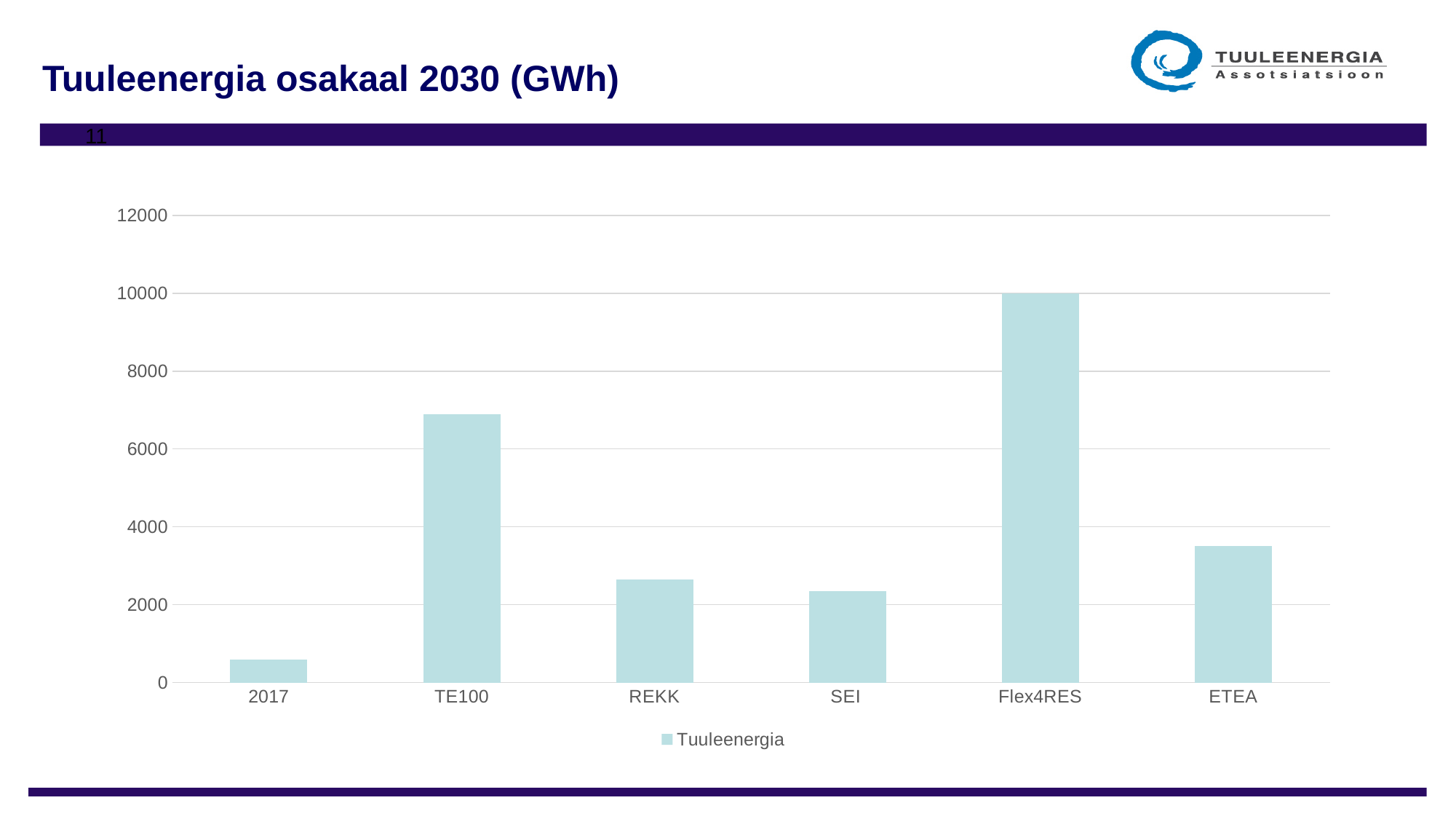
Is the value for SEI greater or less than 2000? greater Is the value for 2017 greater or less than 2000? less How many series does the legend list? 1 Which category has the highest value in the chart? Flex4RES What kind of chart is shown on the slide? bar chart Which category has the lowest value in the chart? 2017 Is the value for TE100 greater or less than 6000? greater Which is larger, the value for TE100 or the value for ETEA? TE100 What is the value for Flex4RES? 10000 What is the name of the series shown in the legend? Tuuleenergia How many categories are shown on the x axis of the chart? 6